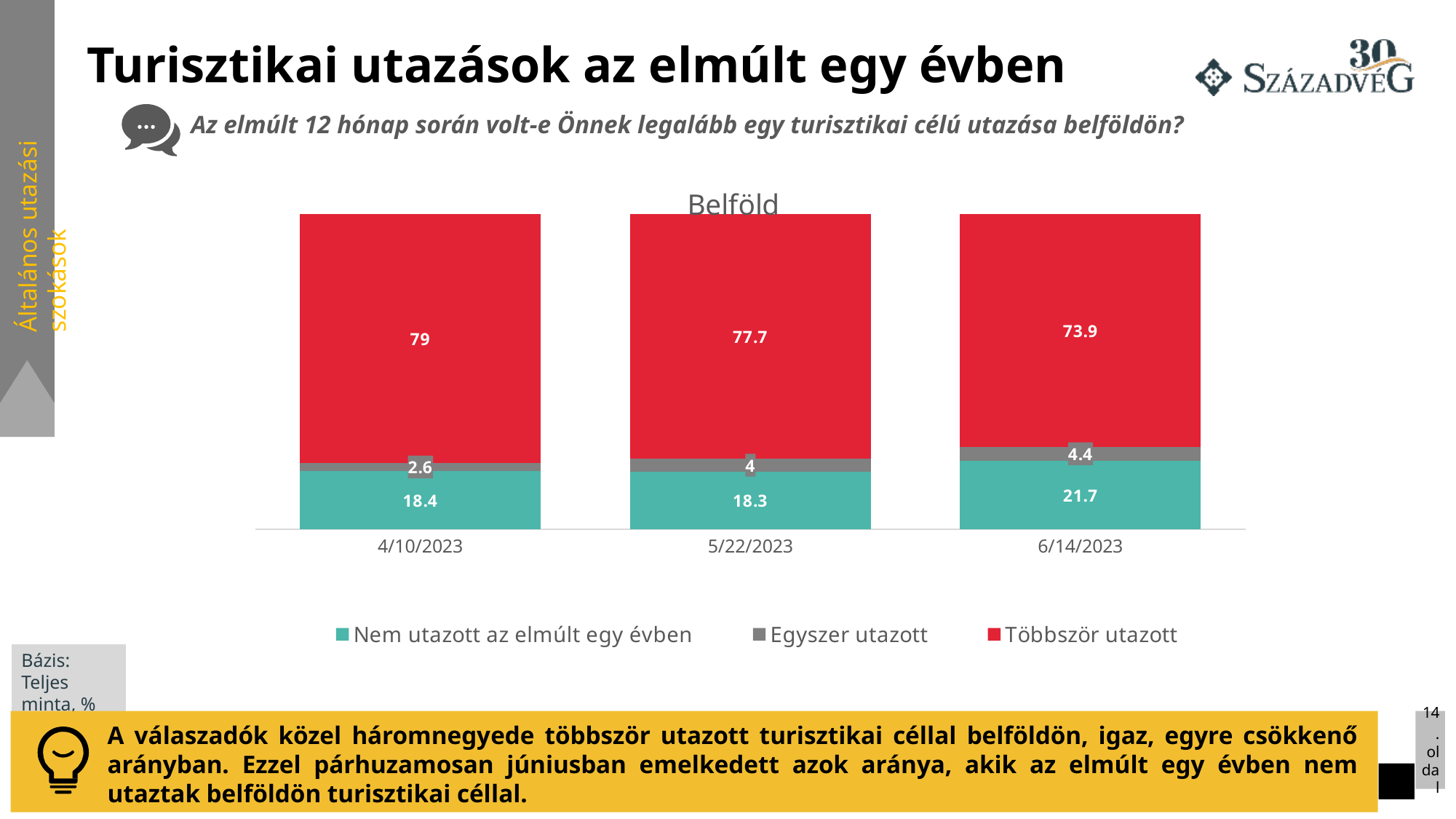
What is the value for "Egyszer utazott" on 5/22/2023? 4 What is the value for "Nem utazott az elmúlt egy évben" on 6/14/2023? 21.7 How many dates (categories) are shown on the x axis? 3 What type of chart is shown on the slide? Stacked bar chart What is the value for "Többször utazott" on 4/10/2023? 79 Which is larger: the "Egyszer utazott" value on 4/10/2023 or on 6/14/2023? 6/14/2023 What is the difference between the "Többször utazott" values on 4/10/2023 and 6/14/2023? 5.1 How many series does the legend list? 3 On which date is the value for "Nem utazott az elmúlt egy évben" the highest? 6/14/2023 On which date is the value for "Többször utazott" the lowest? 6/14/2023 Does the value for "Többször utazott" rise or fall across the dates from 4/10/2023 to 6/14/2023? Fall What is the title of the chart? Belföld